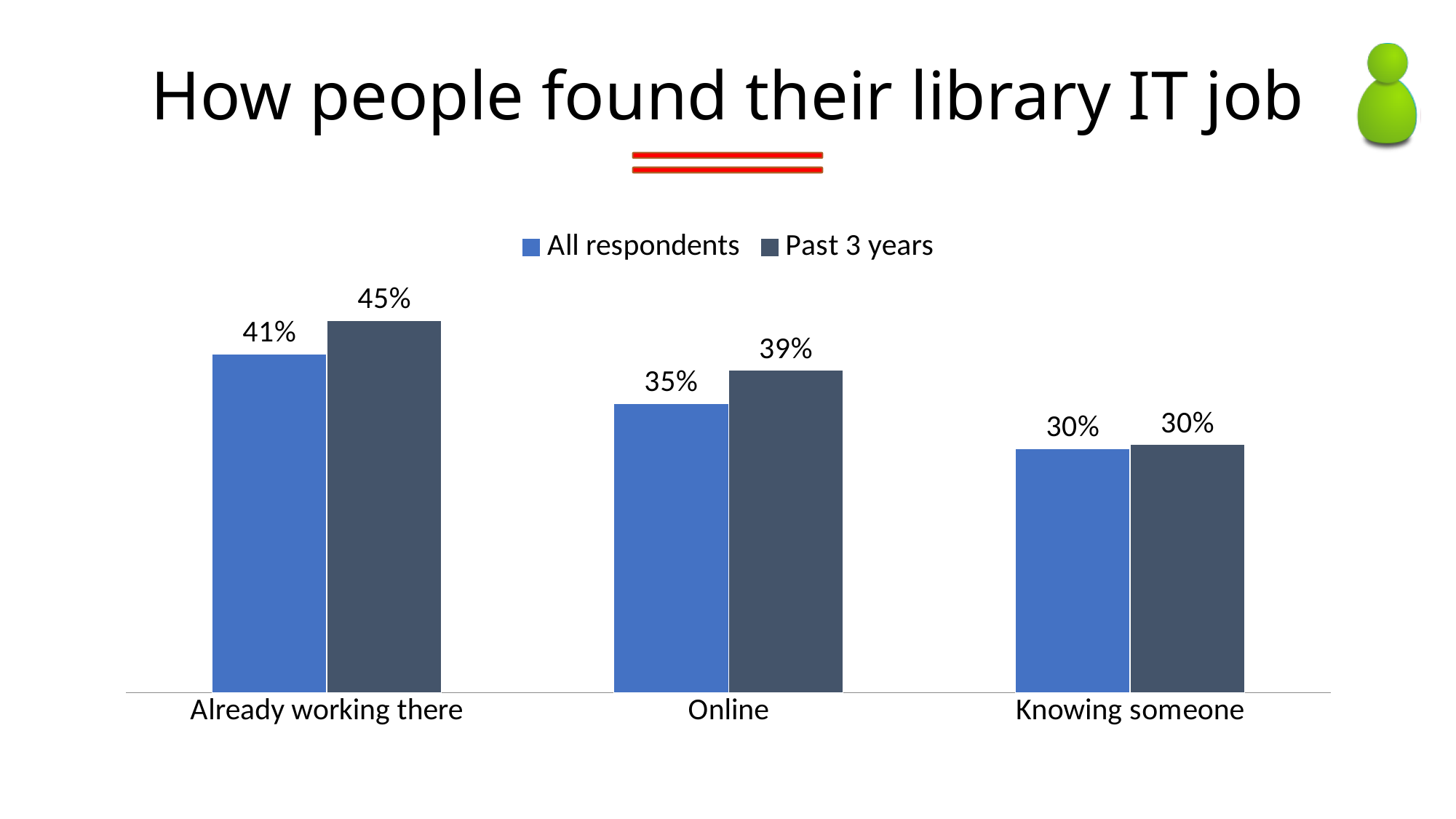
What is the difference between the All respondents values for Already working there and Online? 6% What is the difference between the Past 3 years and All respondents values for Already working there? 4% What percentage of all respondents found their library IT job by already working there? 41% Which category has the lowest value for All respondents? Knowing someone What is the Past 3 years value for Online? 39% How many categories are shown on the x axis? 3 What kind of chart is shown on the slide? Bar chart For Online, which series has the larger value, All respondents or Past 3 years? Past 3 years What is the All respondents value for Knowing someone? 30% How many series does the legend list? 2 Which category has the highest value for the Past 3 years series? Already working there What is the title of the slide? How people found their library IT job